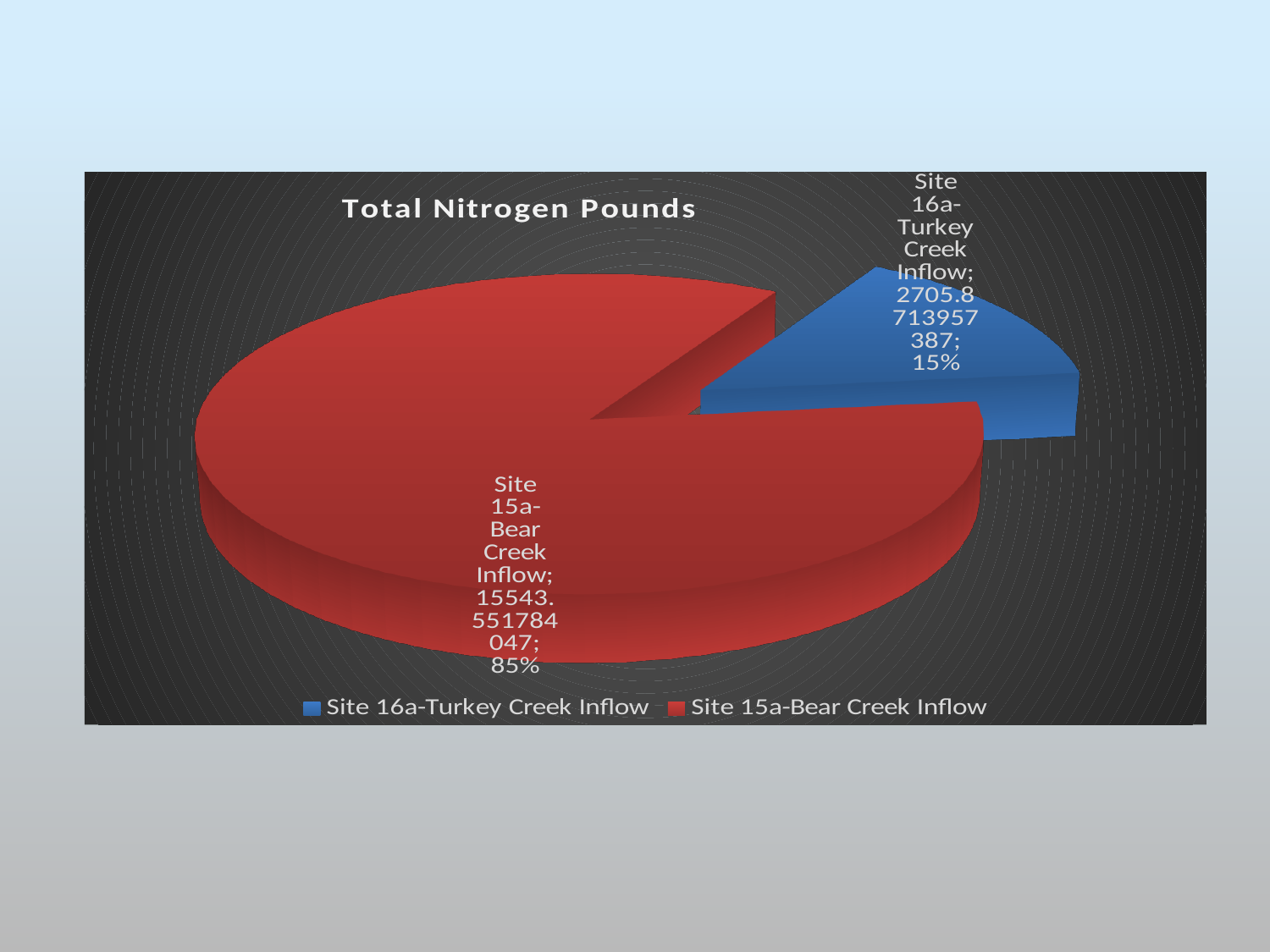
What colour is the slice for Site 16a-Turkey Creek Inflow? blue What is the title of the chart? Total Nitrogen Pounds What share of the pie does Site 16a-Turkey Creek Inflow represent? 15% Which site has the smallest slice of the pie? Site 16a-Turkey Creek Inflow What kind of chart is shown on the slide? pie chart What share of the pie does Site 15a-Bear Creek Inflow represent? 85% How many slices does the pie chart have? 2 Which is larger, the value for Site 15a-Bear Creek Inflow or Site 16a-Turkey Creek Inflow? Site 15a-Bear Creek Inflow How many entries does the legend list? 2 What is the value shown for Site 16a-Turkey Creek Inflow? 2705.8713957387 Which site has the largest slice of the pie? Site 15a-Bear Creek Inflow What is the value shown for Site 15a-Bear Creek Inflow? 15543.551784047